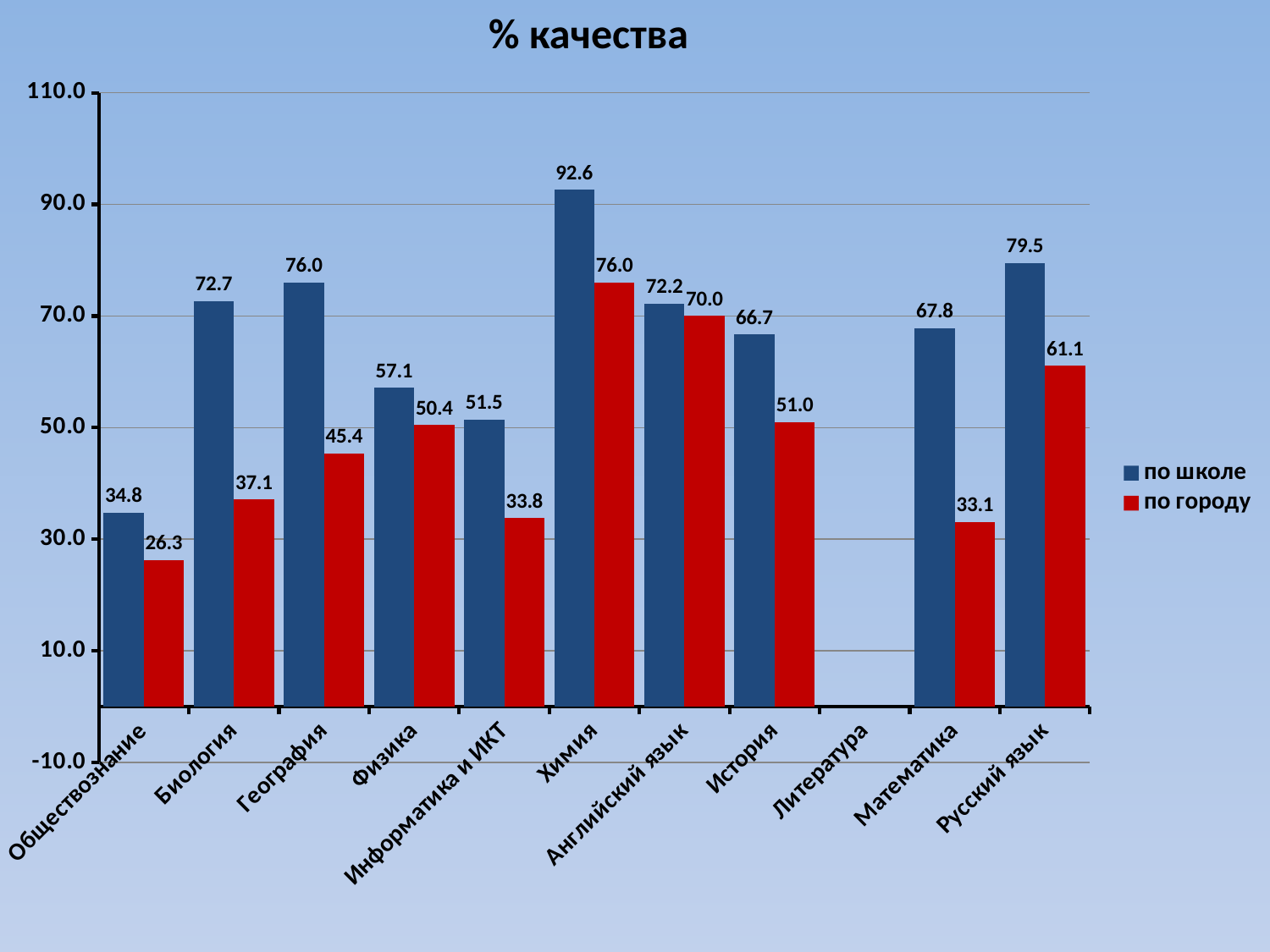
What is the value for Математика in the по городу series? 33.1 What is the title of the chart? % качества How many categories are shown on the x axis? 11 How many series does the legend list? 2 Is the по городу value for Русский язык greater or less than 50.0? greater What is the value for Химия in the по школе series? 92.6 What is the value for Информатика и ИКТ in the по школе series? 51.5 What kind of chart is shown on the slide? bar chart What is the difference between the по школе and по городу values for Биология? 35.6 Which is larger for Английский язык: the по школе value or the по городу value? по школе Which category has the highest value in the по школе series? Химия Which category has the lowest value in the по городу series? Обществознание